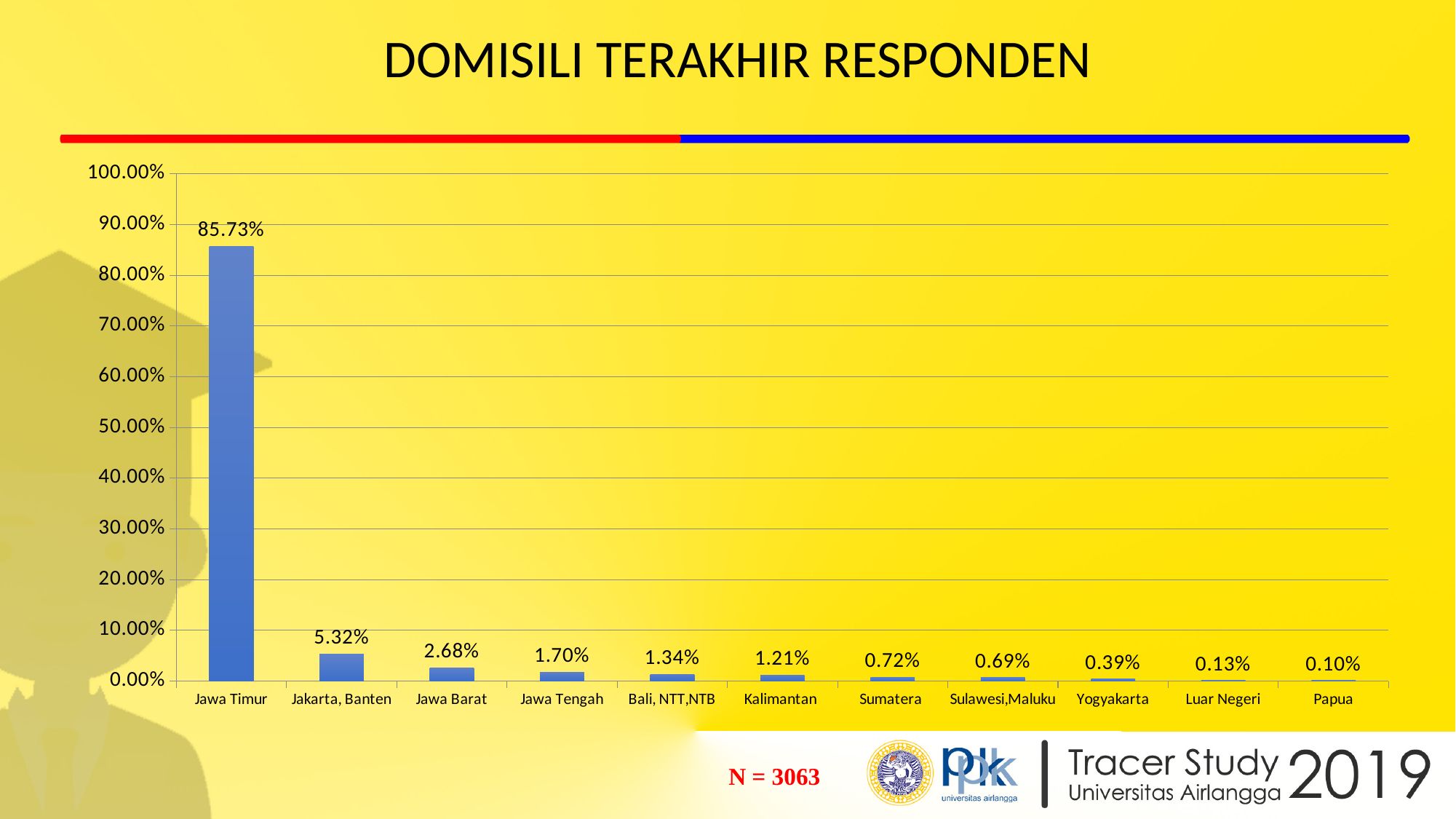
What is the value for Jawa Timur? 85.73% Which is larger, the value for Jawa Barat or the value for Jawa Tengah? Jawa Barat Is the value for Jawa Timur greater or less than 80.00%? greater What is the difference between the values for Jawa Timur and Jakarta, Banten? 80.41% What is the value for Luar Negeri? 0.13% Which category has the highest value? Jawa Timur Which category has the lowest value? Papua How many categories are shown on the x axis? 11 What kind of chart is shown on the slide? bar chart What is the value for Jakarta, Banten? 5.32% What is the value for Kalimantan? 1.21% What is the title of the slide? DOMISILI TERAKHIR RESPONDEN